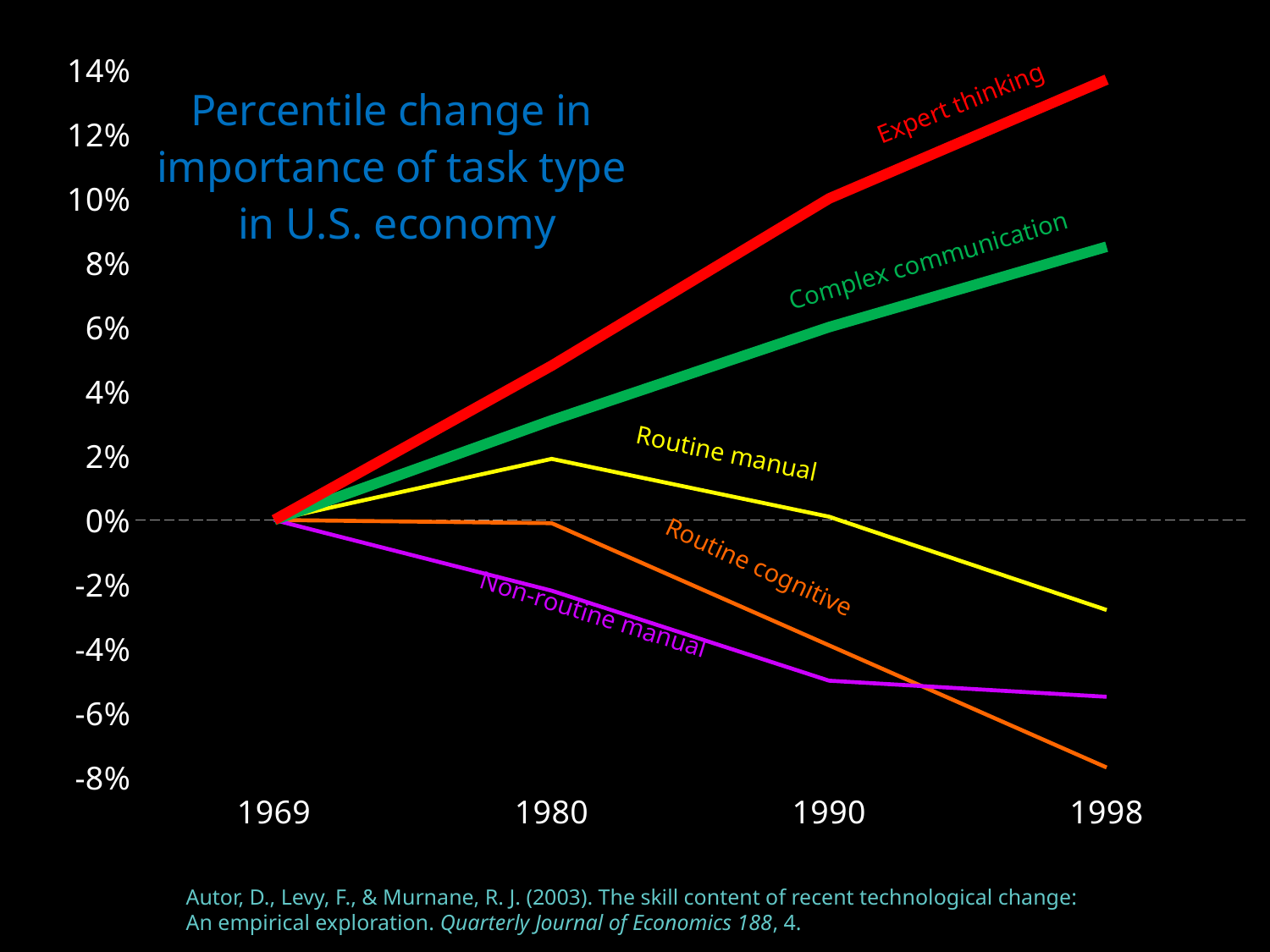
Is the value for Expert thinking in 1998 greater or less than 12%? greater How many years are marked on the x axis? 4 Which task type has the highest value in 1998? Expert thinking Which task type has the lowest value in 1998? Routine cognitive What is the title of the chart? Percentile change in importance of task type in U.S. economy Is the value for Routine cognitive in 1998 greater or less than -6%? less What is the value for Complex communication in 1969? 0% In 1998, which is larger: Expert thinking or Complex communication? Expert thinking How many task-type series are plotted on the chart? 5 Does the Routine cognitive line rise or fall from 1980 to 1998? fall What kind of chart is shown on the slide? line chart Is the value for Non-routine manual in 1998 greater or less than -4%? less